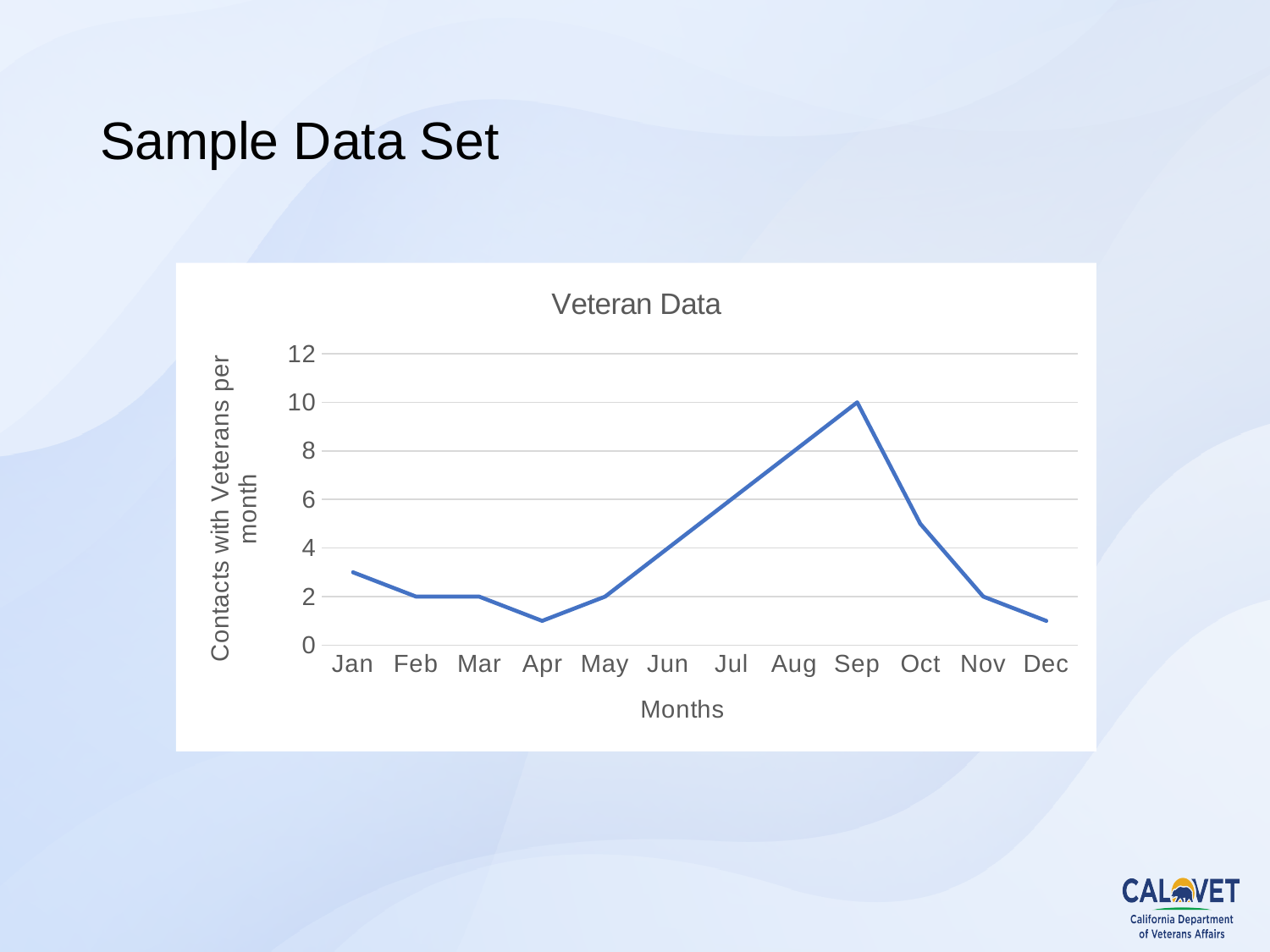
What is the difference between the values for Sep and Aug? 2 What is the title of the chart? Veteran Data Is the value for Oct greater or less than 4? greater How many months are plotted on the x axis? 12 What type of chart is shown on the slide? line chart Is the value for Apr greater or less than 2? less Which month has the highest number of contacts with veterans? Sep Do the values rise or fall from Jun to Sep? rise What is the value for Aug? 8 What is the value for Jun? 4 Which is larger, the value for Jul or the value for Feb? Jul What is the value for Sep? 10